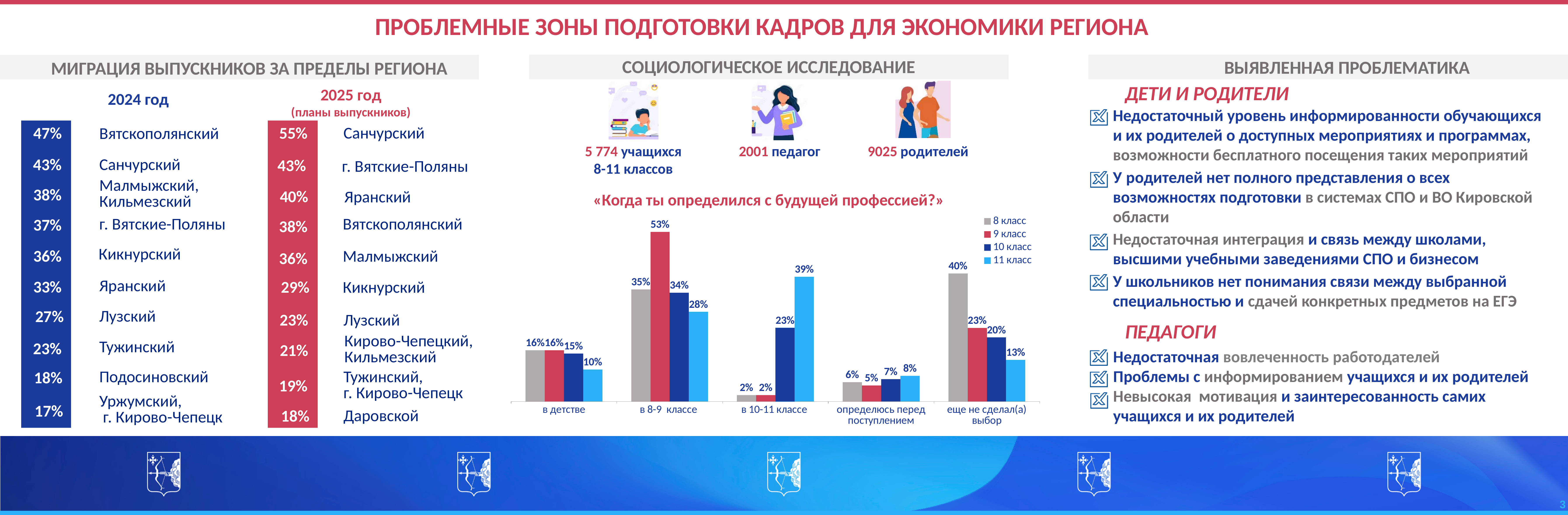
In the chart «Когда ты определился с будущей профессией?», what is the value for 9 класс in the category «в 8-9 классе»? 53% In the chart «Когда ты определился с будущей профессией?», what is the difference between the 11 класс and 10 класс values in the category «в 10-11 классе»? 16% What kind of chart is shown under the title «Когда ты определился с будущей профессией?»? bar chart In the chart «Когда ты определился с будущей профессией?», what is the value for 8 класс in the category «еще не сделал(а) выбор»? 40% In the chart «Когда ты определился с будущей профессией?», what is the value for 11 класс in the category «в 10-11 классе»? 39% In the chart «Когда ты определился с будущей профессией?», which series has the highest value in the category «в 8-9 классе»? 9 класс In the chart «Когда ты определился с будущей профессией?», which series has the lowest value in the category «в детстве»? 11 класс In the chart «Когда ты определился с будущей профессией?», which legend entry is shown in red? 9 класс In the chart «Когда ты определился с будущей профессией?», which is larger in the category «еще не сделал(а) выбор»: the value for 9 класс or for 11 класс? 9 класс How many series does the legend of the chart «Когда ты определился с будущей профессией?» list? 4 How many categories are shown along the x axis of the chart «Когда ты определился с будущей профессией?»? 5 In the chart «Когда ты определился с будущей профессией?», what is the value for 10 класс in the category «определюсь перед поступлением»? 7%